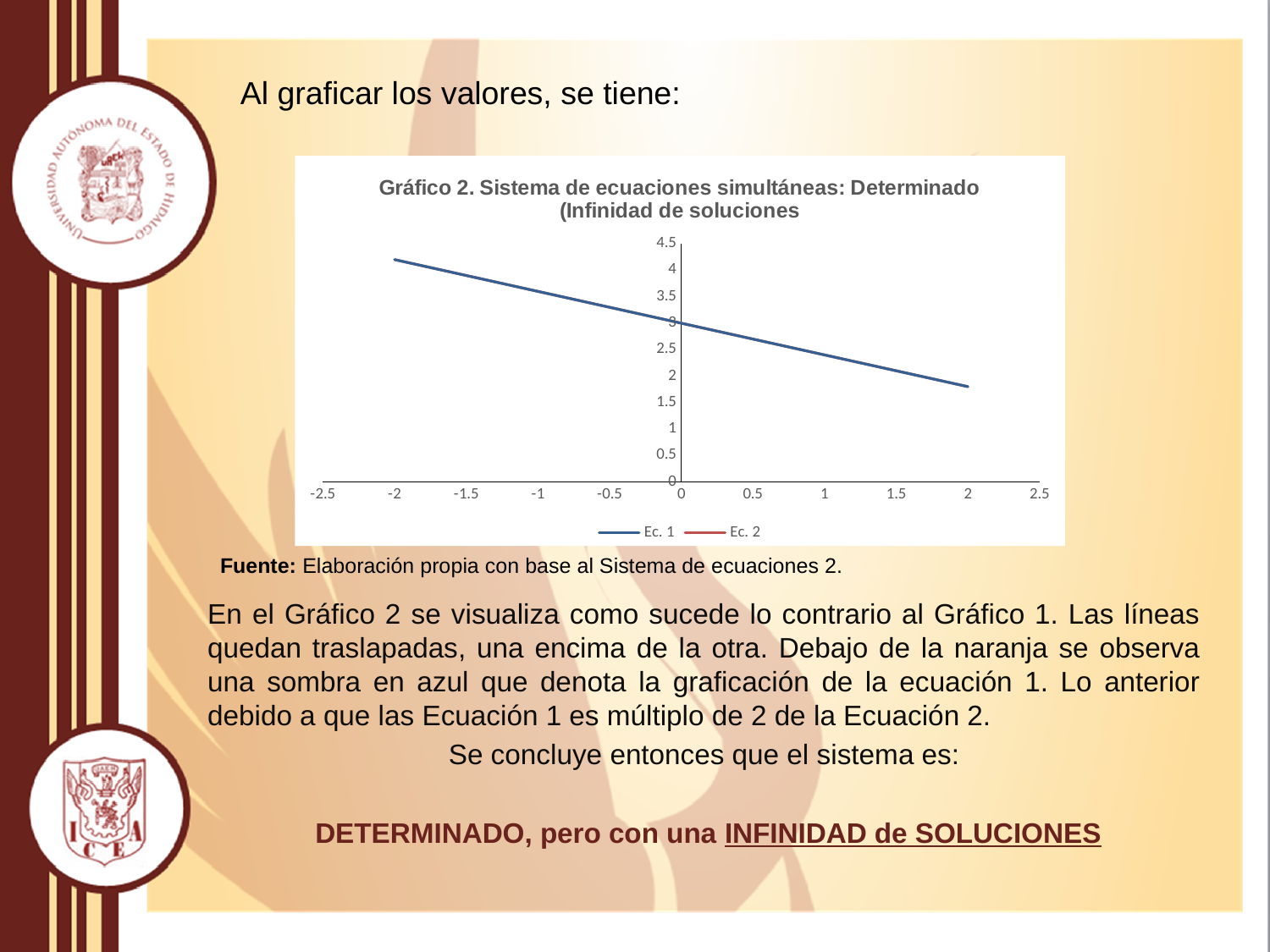
Is the value of the line at x = 0 greater or less than 2? greater What are the names of the series listed in the chart legend? Ec. 1 and Ec. 2 How many series does the chart legend list? 2 What kind of chart is shown on the slide? line chart What is the highest tick value shown on the vertical axis? 4.5 Is the value of the line at x = 2 greater or less than 2.5? less Is the value of the line at x = 1 greater or less than 3? less What is the title of the chart? Gráfico 2. Sistema de ecuaciones simultáneas: Determinado (Infinidad de soluciones Which is larger, the value of the line at x = -1 or at x = 1? x = -1 Do the plotted values rise or fall as x increases from -2 to 2? fall